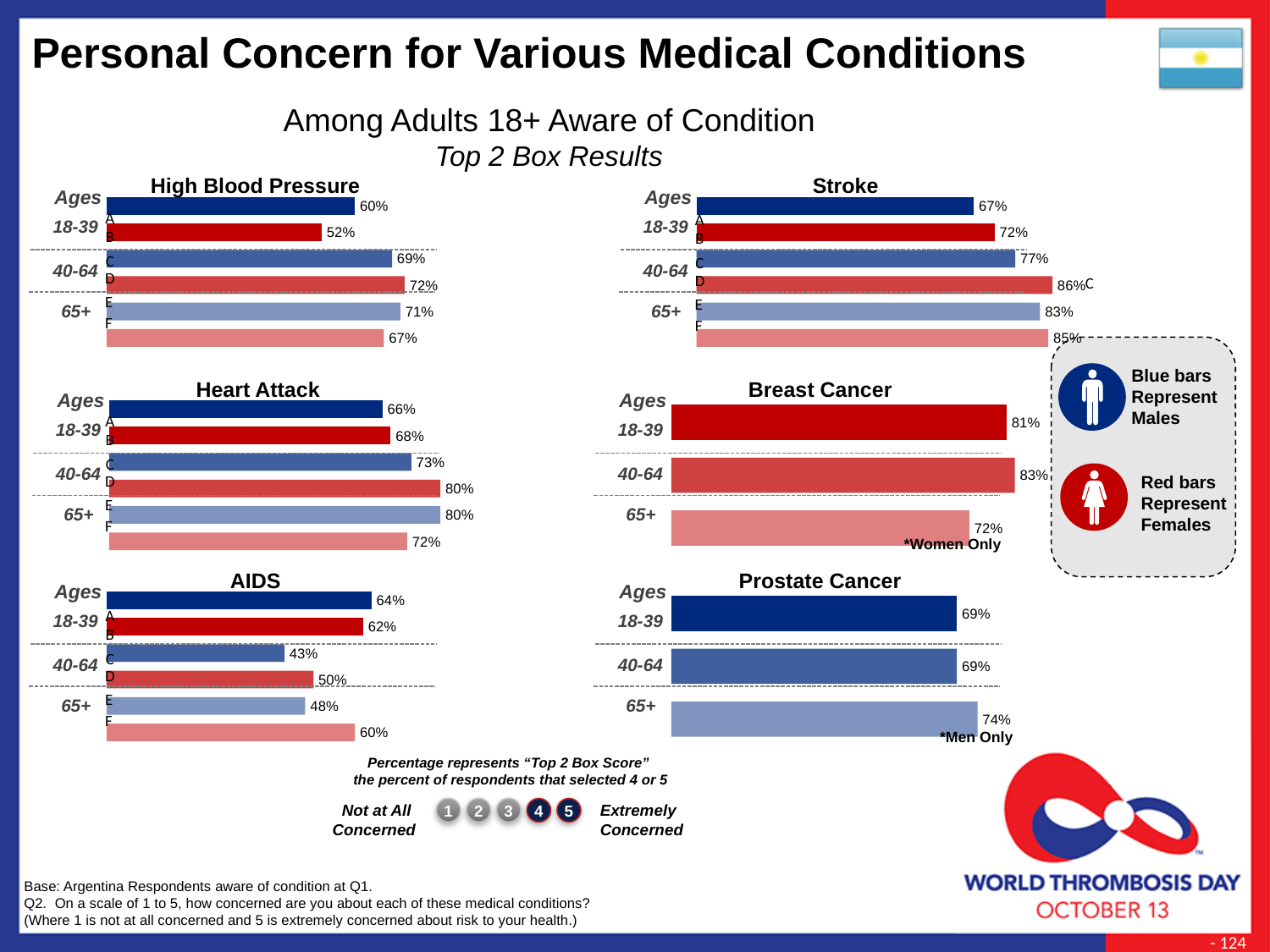
In the Breast Cancer chart, which age group has the highest value? 40-64 In the Stroke chart, what is the value for females aged 40-64? 86% What type of chart is used for Heart Attack? Bar chart According to the legend, what do the blue bars represent? Males In the Stroke chart, which is larger for ages 18-39: the male value or the female value? Female (72%) In the High Blood Pressure chart, what is the value for males aged 18-39? 60% In the Prostate Cancer chart, do the values rise or fall from the 40-64 group to the 65+ group? Rise In the High Blood Pressure chart, what is the difference between the female 40-64 value and the female 18-39 value? 20 percentage points In the Heart Attack chart, what is the value for females aged 65+? 72% In the Prostate Cancer chart, what is the difference between the 65+ value and the 18-39 value? 5 percentage points In the AIDS chart, which bar has the lowest value? Males aged 40-64 (43%) How many age groups are shown in the Breast Cancer chart? 3